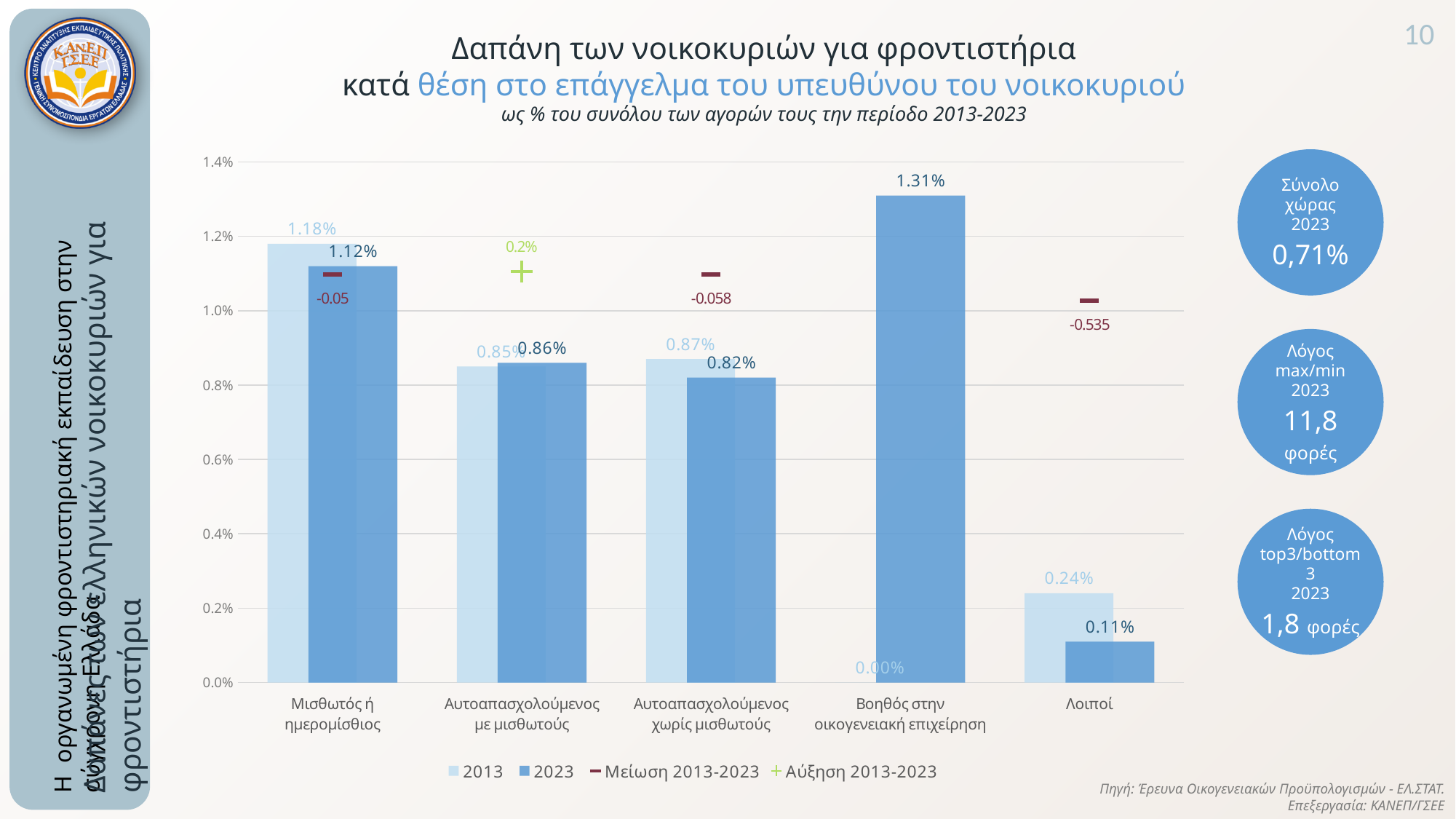
How many categories are shown on the x axis? 5 What is the 2013 value for Αυτοαπασχολούμενος χωρίς μισθωτούς? 0.87% What kind of chart is shown on the slide? Bar chart How many entries does the legend list? 4 What is the difference between the 2013 and 2023 values for Λοιποί? 0.13% Which is larger for Μισθωτός ή ημερομίσθιος: the 2013 value or the 2023 value? 2013 Which category has the highest 2023 value? Βοηθός στην οικογενειακή επιχείρηση What is the 2023 value for Λοιποί? 0.11% Which category has the lowest 2013 value? Βοηθός στην οικογενειακή επιχείρηση Is the 2023 value for Αυτοαπασχολούμενος με μισθωτούς greater or less than 0.8%? greater What is the 2023 value for Βοηθός στην οικογενειακή επιχείρηση? 1.31% What is the 2013 value for Μισθωτός ή ημερομίσθιος? 1.18%